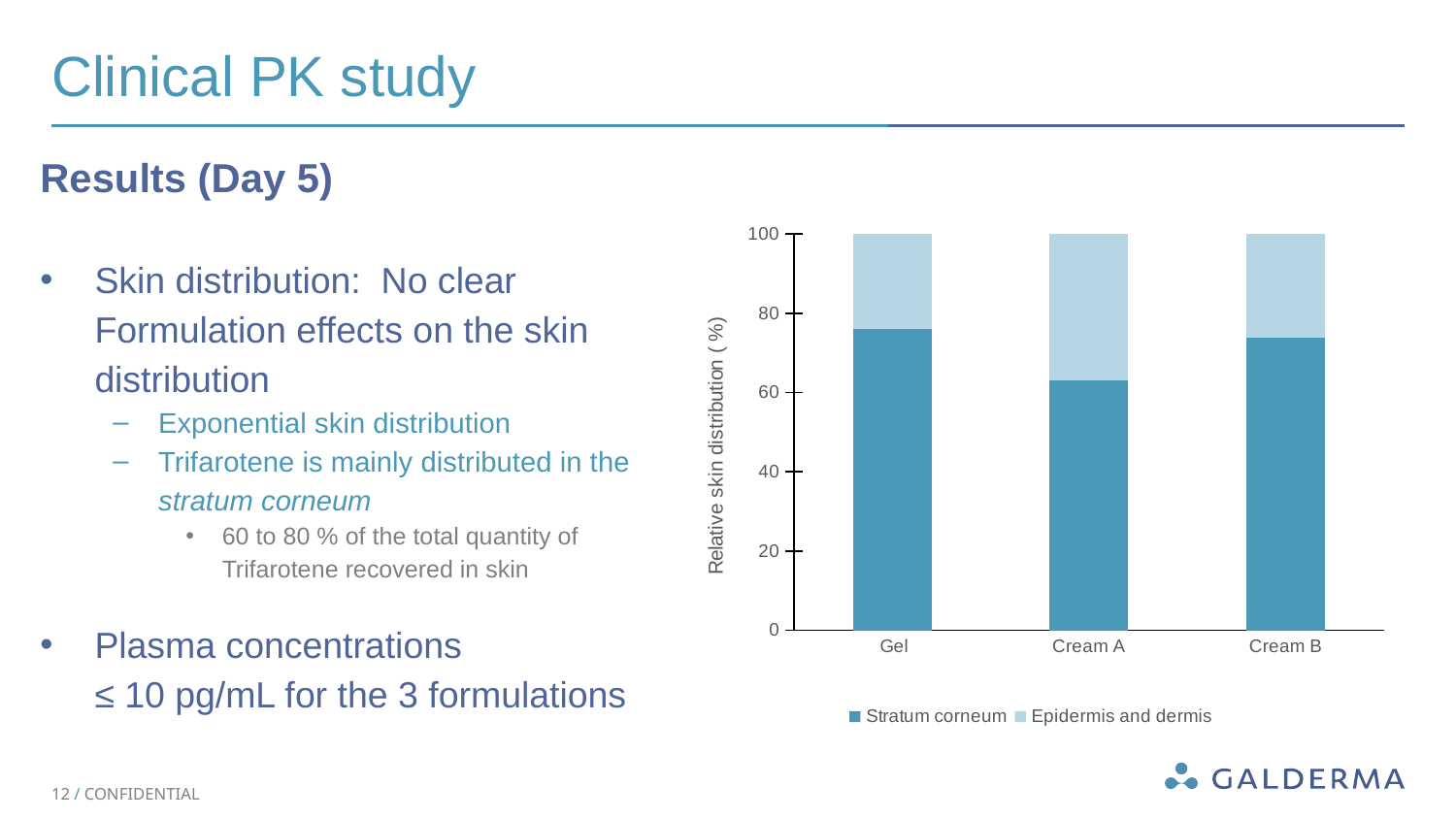
How many series does the chart legend list? 2 What is the total height of the stacked bar for Gel? 100 What are the two series named in the chart legend? Stratum corneum; Epidermis and dermis Which formulation has the lowest Stratum corneum value in the chart? Cream A What is the label of the y axis of the chart? Relative skin distribution ( %) How many formulations (categories) are shown on the x axis of the chart? 3 Which has a larger Stratum corneum value, Gel or Cream A? Gel Is the Stratum corneum value for Cream B greater or less than 80? less Which has a larger Stratum corneum value, Cream A or Cream B? Cream B Is the Stratum corneum value for Cream A greater or less than 80? less What kind of chart is shown on the slide? Stacked bar chart Is the Stratum corneum value for Gel greater or less than 60? greater